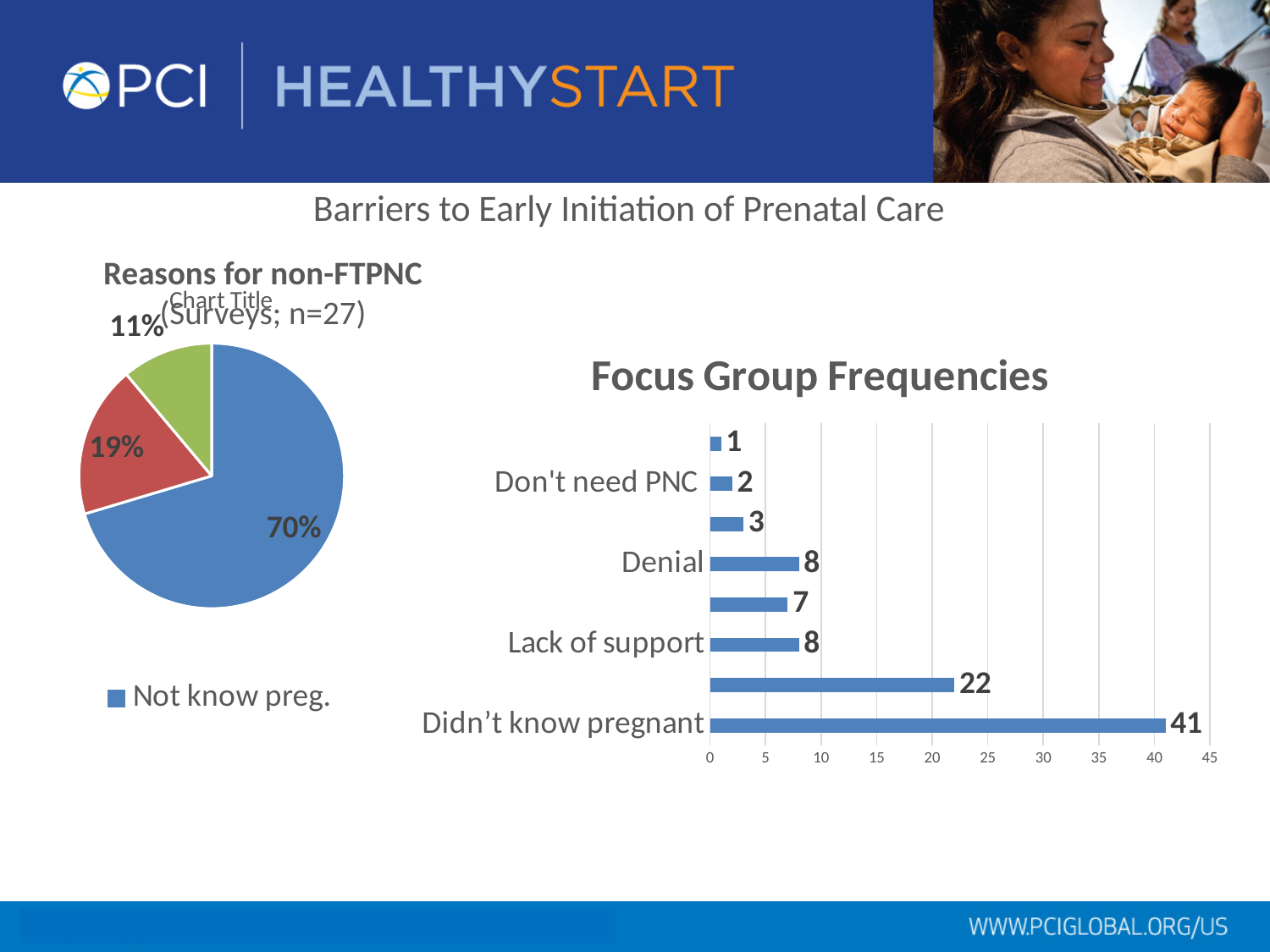
How many bars are plotted in the Focus Group Frequencies chart? 8 In the Focus Group Frequencies chart, which labelled category has the highest value? Didn't know pregnant In the Focus Group Frequencies chart, which is larger, the value for Denial or the value for Don't need PNC? Denial In the Focus Group Frequencies chart, what is the value for Denial? 8 In the Focus Group Frequencies chart, what is the value for Lack of support? 8 In the Reasons for non-FTPNC pie chart, what is the percentage of the smallest slice? 11% In the Focus Group Frequencies chart, what is the value for Didn't know pregnant? 41 How many slices does the Reasons for non-FTPNC pie chart have? 3 In the Focus Group Frequencies chart, what is the value for Don't need PNC? 2 In the Reasons for non-FTPNC pie chart, what share does the Not know preg. slice have? 70% In the Focus Group Frequencies chart, what is the difference between the values for Didn't know pregnant and Denial? 33 What kind of chart is the Focus Group Frequencies chart? bar chart